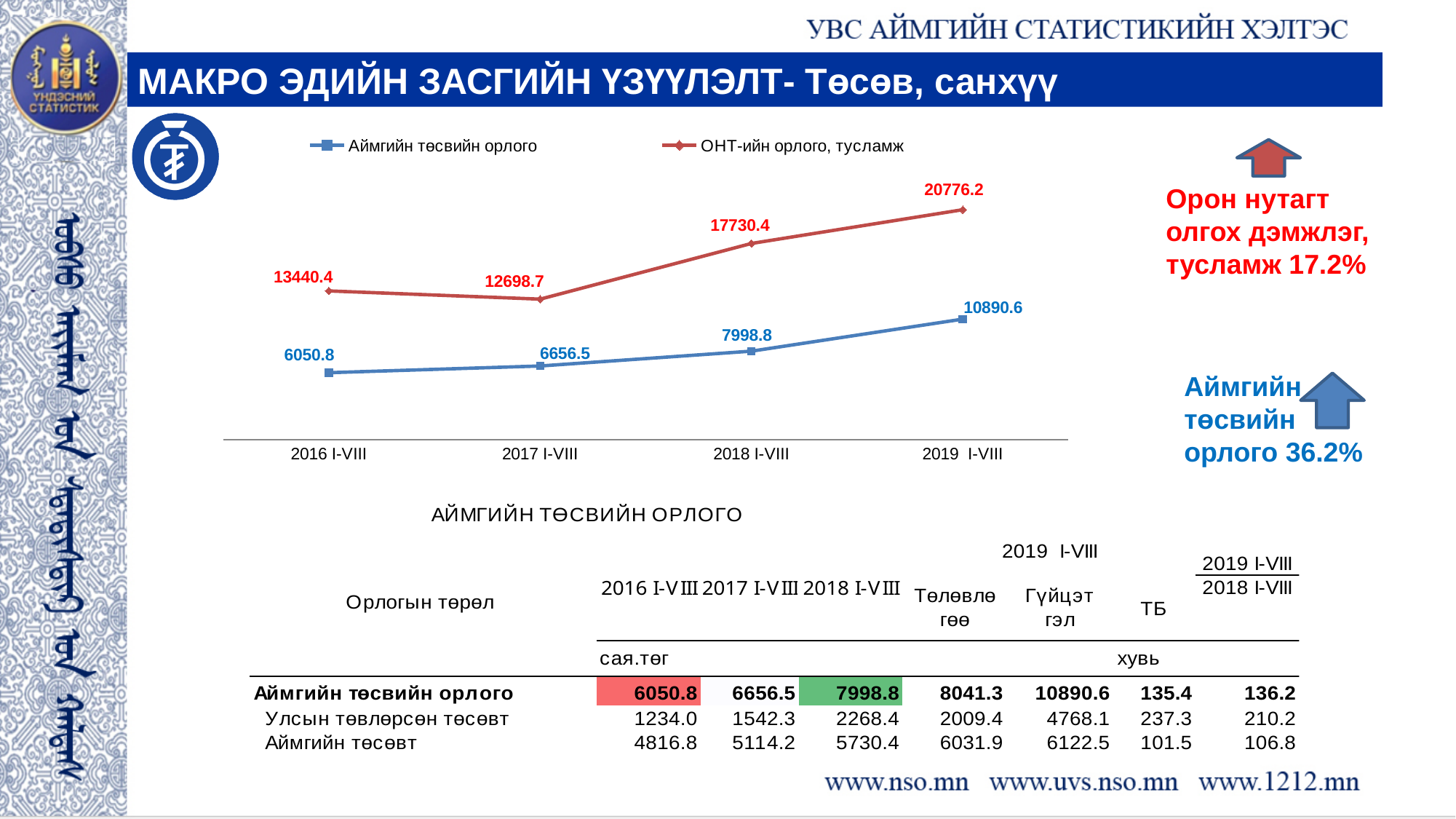
What is the value of Аймгийн төсвийн орлого for 2019 I-VIII? 10890.6 How many series does the chart legend list? 2 Which colour is used for the ОНТ-ийн орлого, тусламж line? red What is the difference between ОНТ-ийн орлого, тусламж and Аймгийн төсвийн орлого in 2018 I-VIII? 9731.6 How many periods are plotted along the x axis of the chart? 4 In which period is ОНТ-ийн орлого, тусламж lowest? 2017 I-VIII What type of chart is shown on the slide? line chart What is the value of ОНТ-ийн орлого, тусламж for 2016 I-VIII? 13440.4 What is the value of ОНТ-ийн орлого, тусламж for 2017 I-VIII? 12698.7 In which period is Аймгийн төсвийн орлого highest? 2019 I-VIII Does Аймгийн төсвийн орлого rise or fall from 2016 I-VIII to 2019 I-VIII? rise Which series has the larger value in 2016 I-VIII, Аймгийн төсвийн орлого or ОНТ-ийн орлого, тусламж? ОНТ-ийн орлого, тусламж